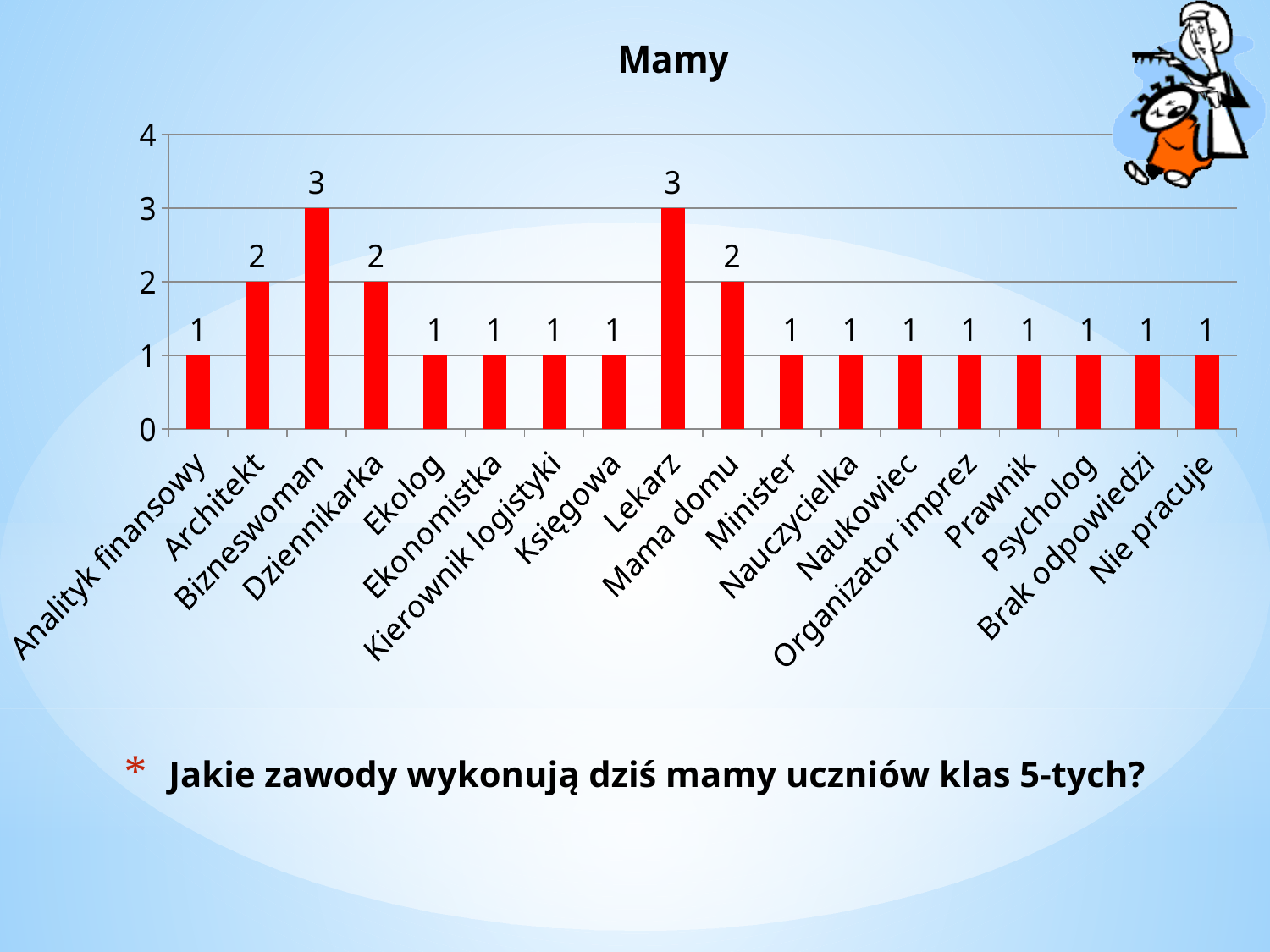
What is the value for Mama domu? 2 Which is larger, the value for Bizneswoman or the value for Ekolog? Bizneswoman Which two categories share the highest value in the chart? Bizneswoman and Lekarz How many categories are shown on the x axis of the chart? 18 What is the highest value shown in the chart? 3 What is the difference between the values for Lekarz and Dziennikarka? 1 What is the title of the chart? Mamy What is the value for Architekt? 2 What type of chart is shown on the slide? bar chart What is the value for Nauczycielka? 1 What colour are the bars in the chart? red What is the value for Bizneswoman? 3